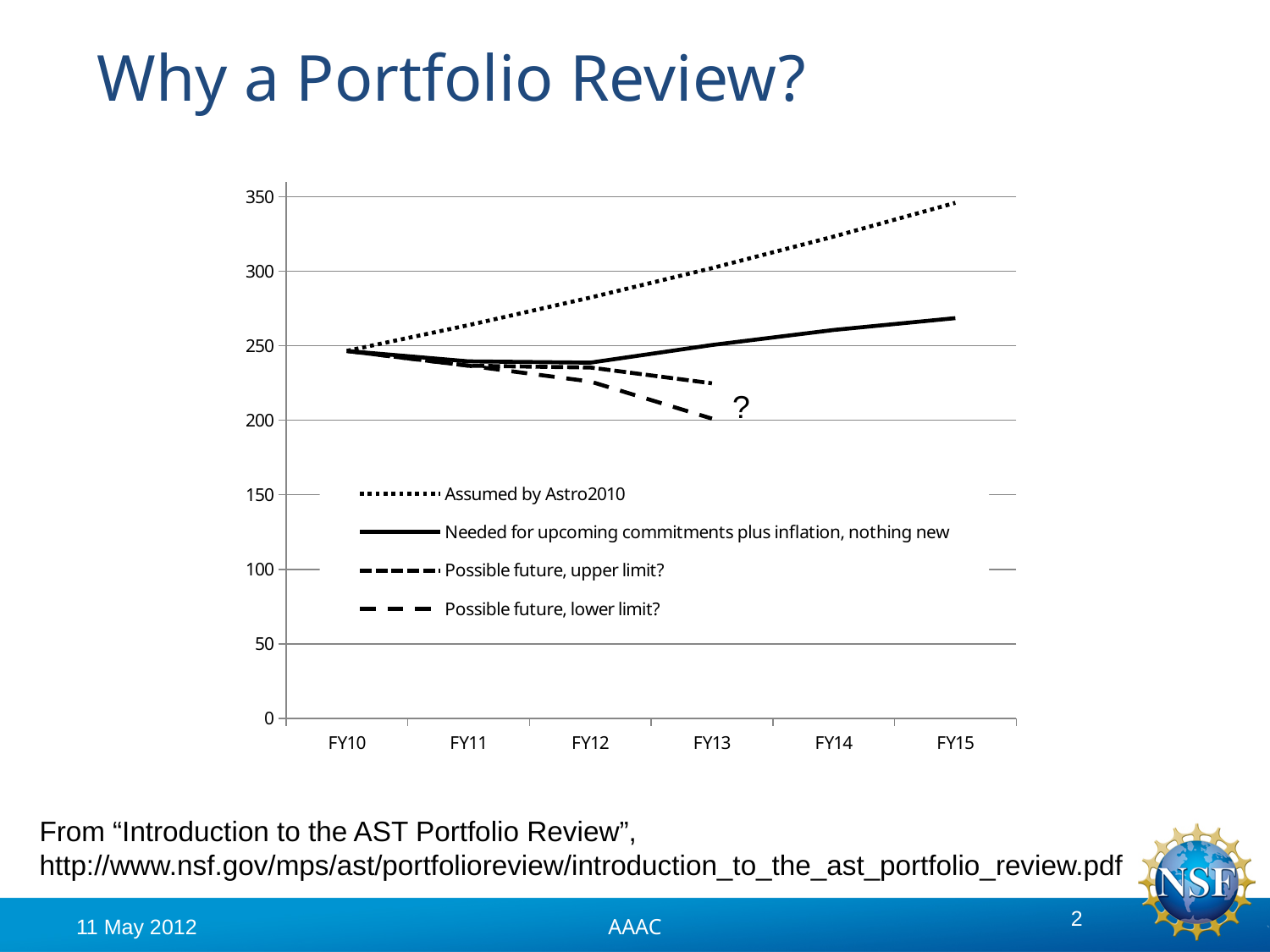
How many series does the legend list? 4 Which series is drawn with a dotted line? Assumed by Astro2010 Is the value for 'Assumed by Astro2010' at FY15 greater or less than 300? greater Which series has the highest value at FY15? Assumed by Astro2010 Is the value for 'Possible future, lower limit?' at FY13 greater or less than 250? less Is the value for 'Assumed by Astro2010' at FY13 greater or less than 250? greater Which series has the lowest value at FY13? Possible future, lower limit? Does the 'Possible future, lower limit?' line rise or fall from FY10 to FY13? fall What kind of chart is shown on the slide? line chart How many fiscal years are labelled on the x axis? 6 Does the 'Assumed by Astro2010' line rise or fall from FY10 to FY15? rise